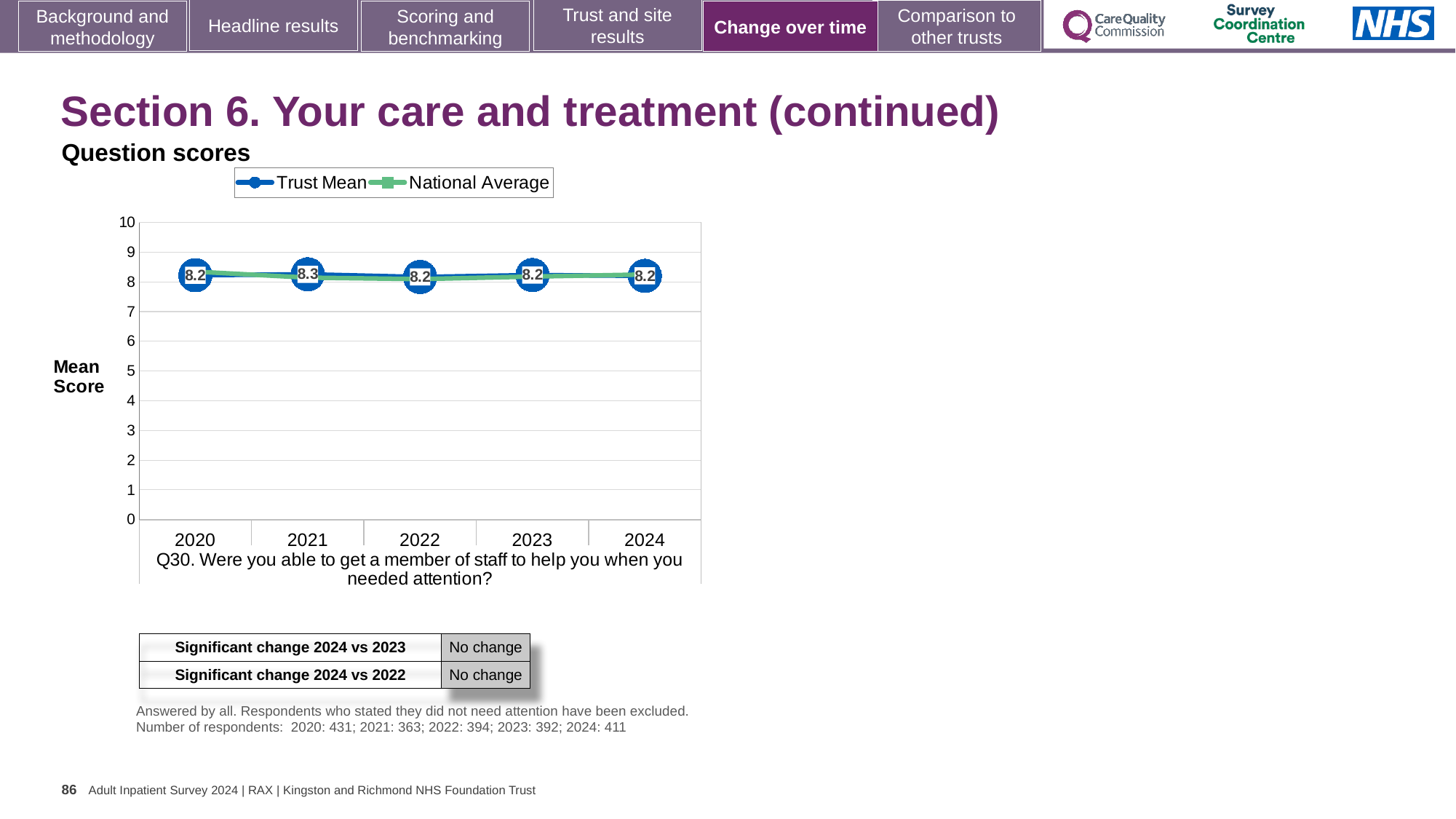
What is the Trust Mean score for 2021? 8.3 What is the Trust Mean score for 2024? 8.2 How many years are plotted on the x axis? 5 Which year has the larger Trust Mean score, 2021 or 2023? 2021 Is the National Average value for 2024 greater or less than 5? greater What kind of chart is shown on the slide? line chart What is the label on the y axis of the chart? Mean Score Which series is shown in blue in the legend? Trust Mean What is the Trust Mean score for 2020? 8.2 In which year is the Trust Mean score highest? 2021 How many series does the legend list? 2 What is the difference between the Trust Mean scores for 2021 and 2022? 0.1